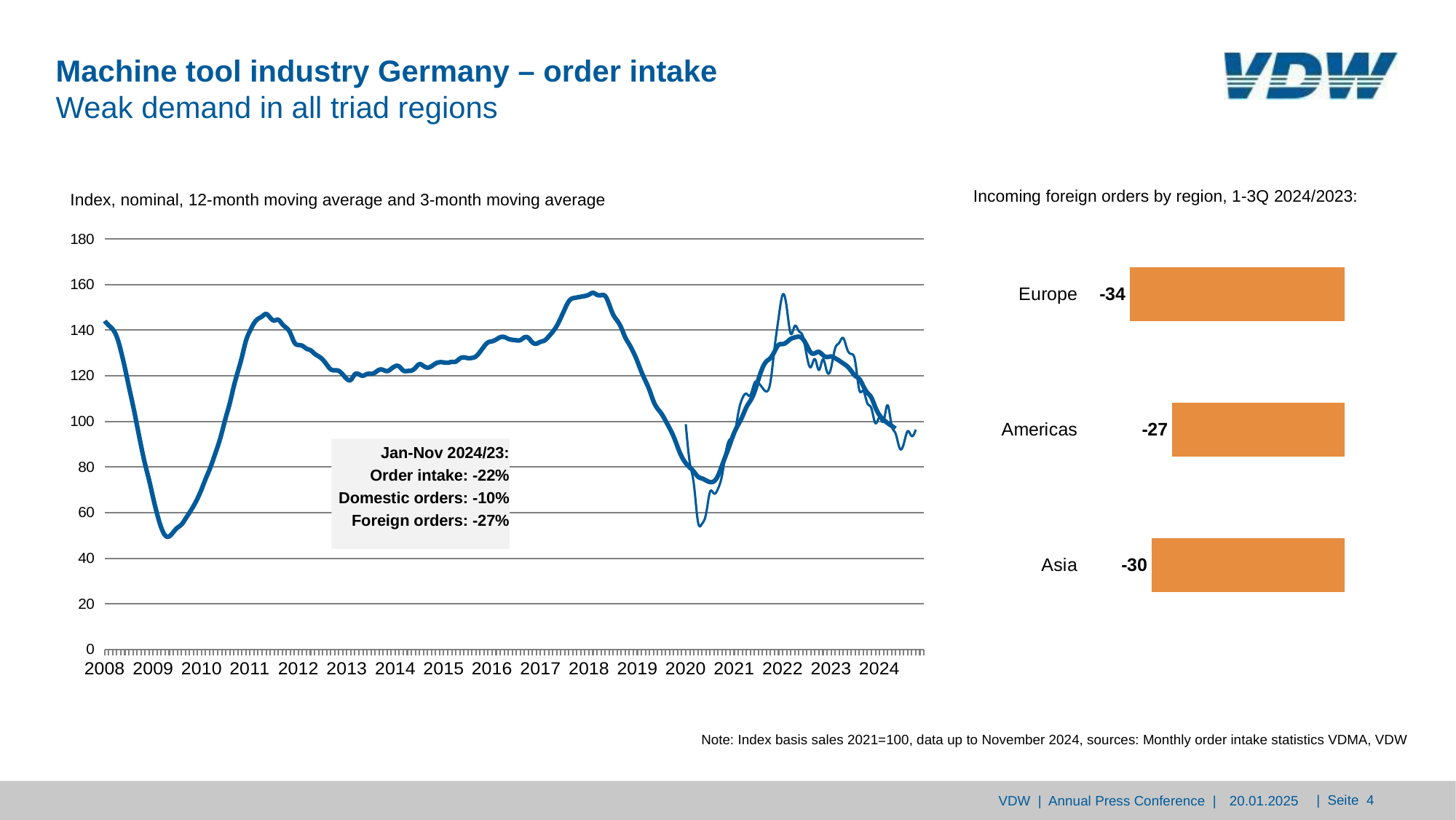
In the chart 'Incoming foreign orders by region, 1-3Q 2024/2023', which region has the highest value? Americas In the left line chart, does the 12-month moving average rise or fall from 2022 to 2024? Fall In the chart 'Incoming foreign orders by region, 1-3Q 2024/2023', what is the value for Europe? -34 In the chart 'Incoming foreign orders by region, 1-3Q 2024/2023', what is the difference between the values for Europe and Americas? 7 According to the text box in the left chart, what was the change in foreign orders for Jan-Nov 2024/23? -27% What kind of chart is the one on the left showing the index of order intake from 2008 to 2024? Line chart In the chart 'Incoming foreign orders by region, 1-3Q 2024/2023', what is the value for Americas? -27 In the chart 'Incoming foreign orders by region, 1-3Q 2024/2023', what is the value for Asia? -30 In the chart 'Incoming foreign orders by region, 1-3Q 2024/2023', how many regions are shown? 3 In the chart 'Incoming foreign orders by region, 1-3Q 2024/2023', which region has the lowest value? Europe In the left line chart, is the lowest value of the index in 2009 greater or less than 60? less What kind of chart is the one on the right showing incoming foreign orders by region? Bar chart